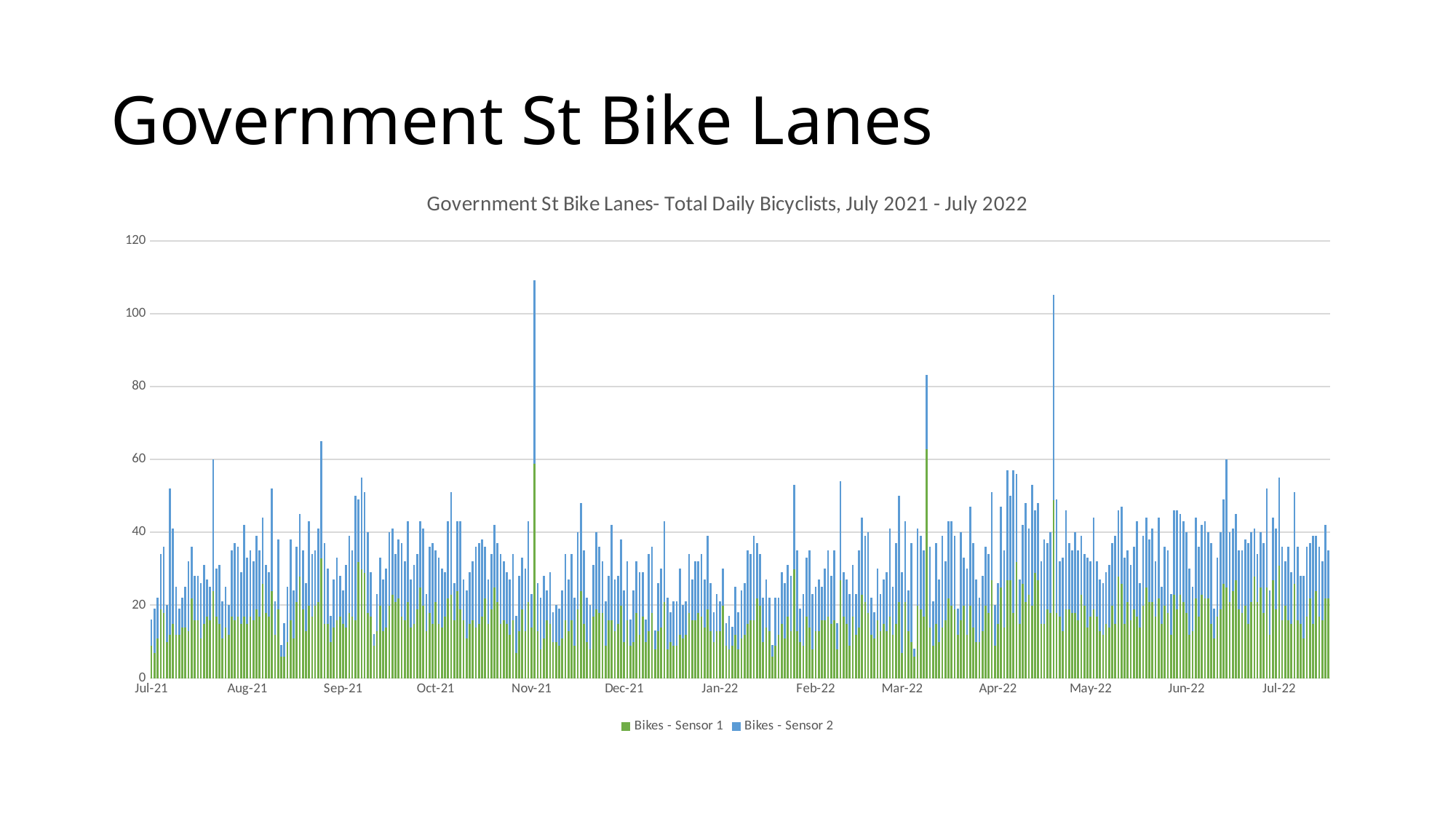
Is the tallest bar between Aug-21 and Sep-21 greater or less than 60? greater Which series is shown in green? Bikes - Sensor 1 How many series does the legend list? 2 How many month labels are shown along the x axis? 13 Is the tall spike between Apr-22 and May-22 greater or less than 100? greater What kind of chart is shown on the slide? Bar chart Which is taller: the spike just before Nov-21 or the spike just after Mar-22? The spike just before Nov-21 Is the spike just after Mar-22 greater or less than 60? greater What is the highest value shown on the vertical axis? 120 What is the title of the chart? Government St Bike Lanes- Total Daily Bicyclists, July 2021 - July 2022